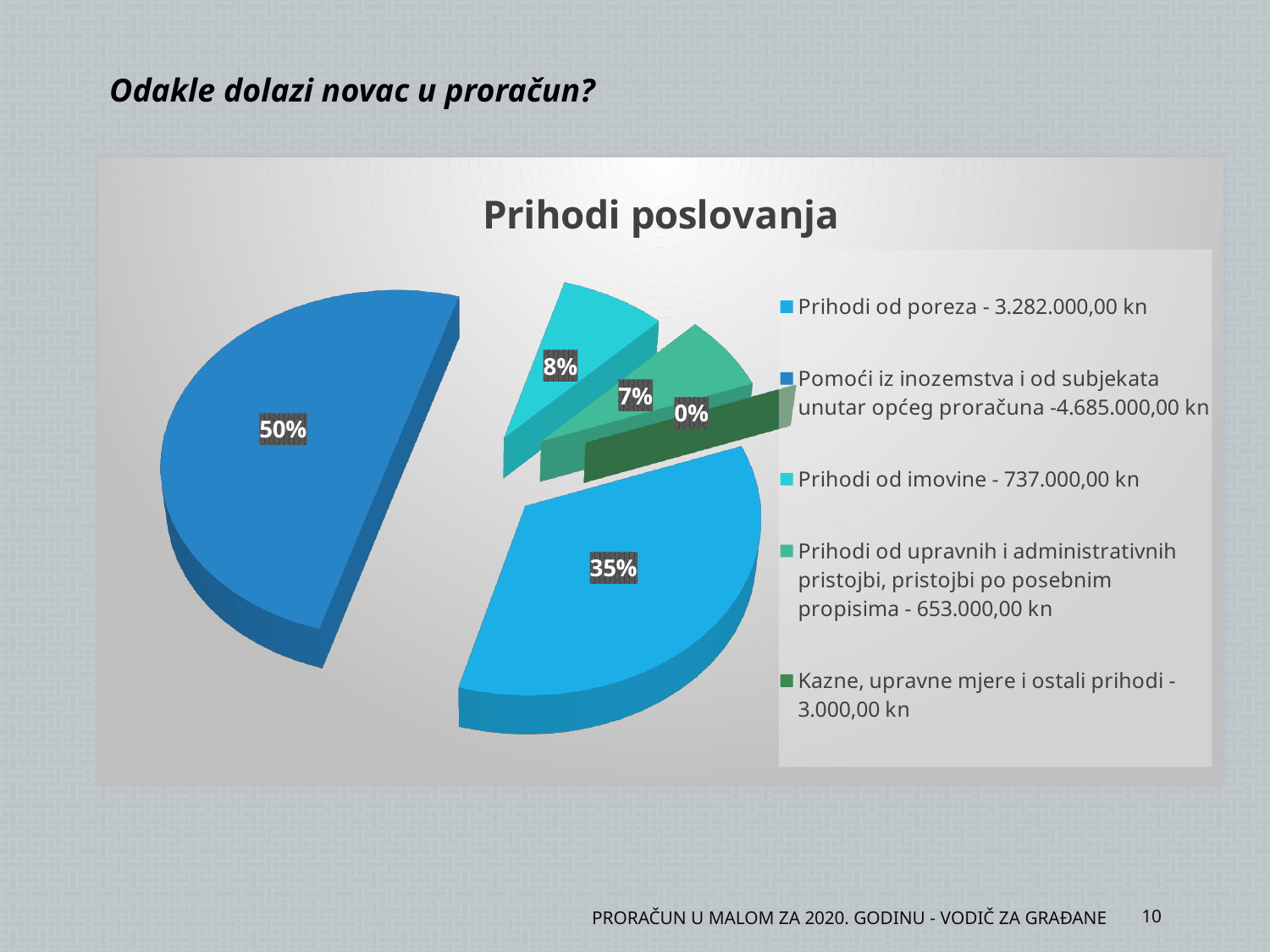
What share of the pie is labelled for 'Prihodi od poreza'? 35% What is the difference in percentage points between the 50% slice and the 35% slice? 15 percentage points What type of chart is shown on the slide? Pie chart What share of the pie is labelled for 'Prihodi od imovine'? 8% Which category has the smallest slice of the pie? Kazne, upravne mjere i ostali prihodi Which category has the largest slice of the pie? Pomoći iz inozemstva i od subjekata unutar općeg proračuna What share of the pie is labelled for 'Pomoći iz inozemstva i od subjekata unutar općeg proračuna'? 50% How many entries does the legend list? 5 How many slices does the pie chart have? 5 What is the title of the chart? Prihodi poslovanja